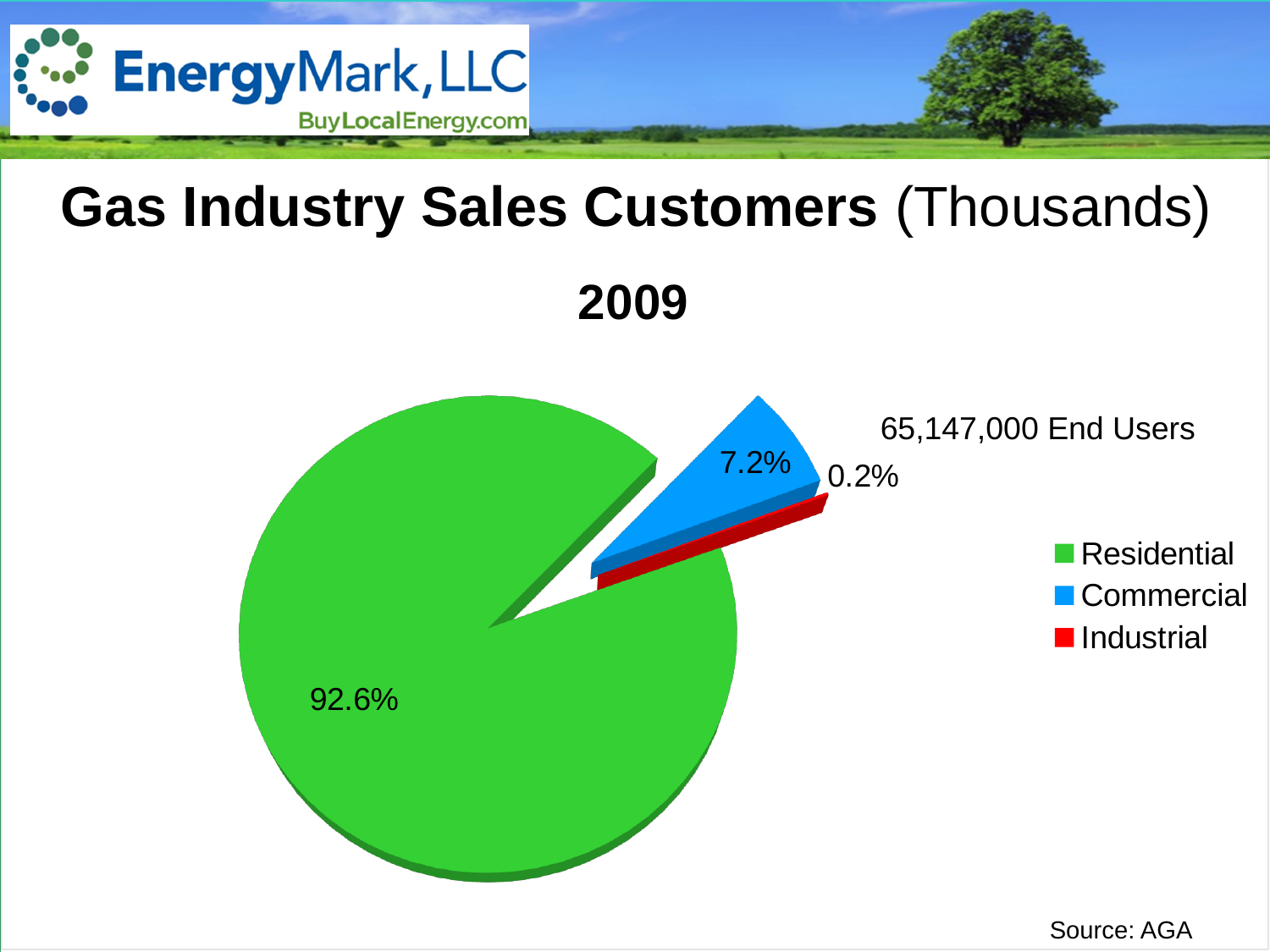
What share of the pie does Residential hold? 92.6% What share of the pie does Industrial hold? 0.2% What year does the chart title give? 2009 Which is larger, the Commercial slice or the Industrial slice? Commercial What kind of chart is shown on the slide? pie chart Which category has the smallest slice of the pie? Industrial Which category has the largest slice of the pie? Residential How many categories does the legend list? 3 What colour represents Commercial in the chart? blue What is the difference in percentage points between the Residential and Commercial shares? 85.4 What share of the pie does Commercial hold? 7.2% What total number of end users is stated next to the chart? 65,147,000 End Users